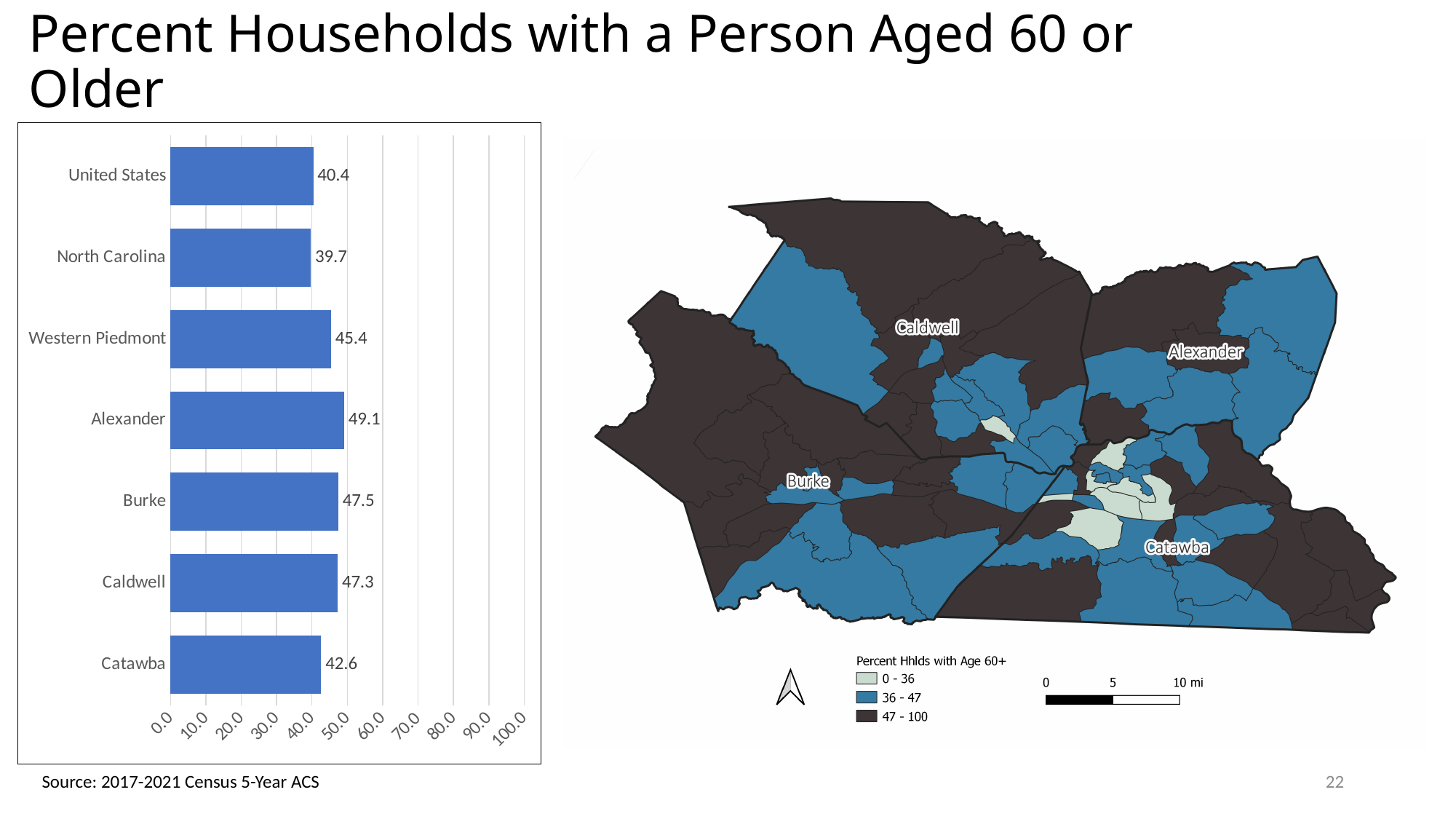
What is the difference between the values for Alexander and Catawba in the bar chart? 6.5 What is the value for Alexander in the bar chart? 49.1 What kind of chart is shown on the left of the slide? Bar chart Which has a larger value in the bar chart, Western Piedmont or Catawba? Western Piedmont What is the difference between the values for Burke and Caldwell in the bar chart? 0.2 Which category has the highest value in the bar chart? Alexander Which category has the lowest value in the bar chart? North Carolina How many categories are shown in the bar chart? 7 What is the value for the United States in the bar chart? 40.4 What is the value for Western Piedmont in the bar chart? 45.4 What is the maximum value shown on the x axis of the bar chart? 100.0 What is the value for Catawba in the bar chart? 42.6